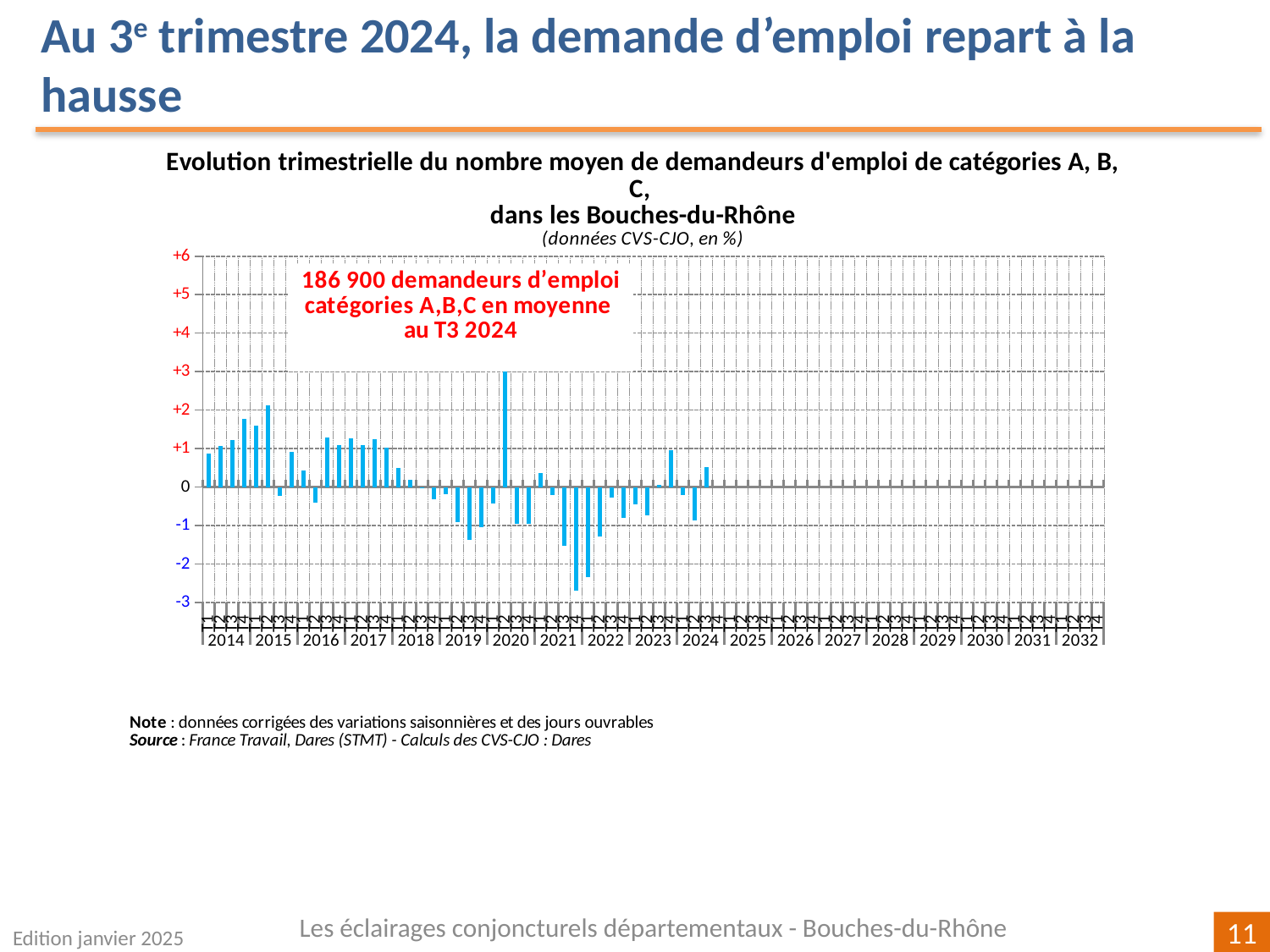
Is the value of the first bar of 2015 greater or less than +1? greater Are the bars for 2019 mostly above or below 0? below In which year does the lowest (most negative) bar of the chart occur? 2021 Is the value of the tallest bar (in 2020) greater or less than +2? greater In what unit are the data of the chart expressed, according to the subtitle? en % According to the annotation on the chart, how many demandeurs d'emploi catégories A,B,C were there on average in T3 2024? 186 900 How many years are labelled on the horizontal axis? 19 What is the highest value shown on the vertical axis? +6 In which year does the tallest (highest) bar of the chart occur? 2020 Is the value of the last bar shown (in 2024) greater or less than 0? greater What kind of chart is shown on the slide? bar chart